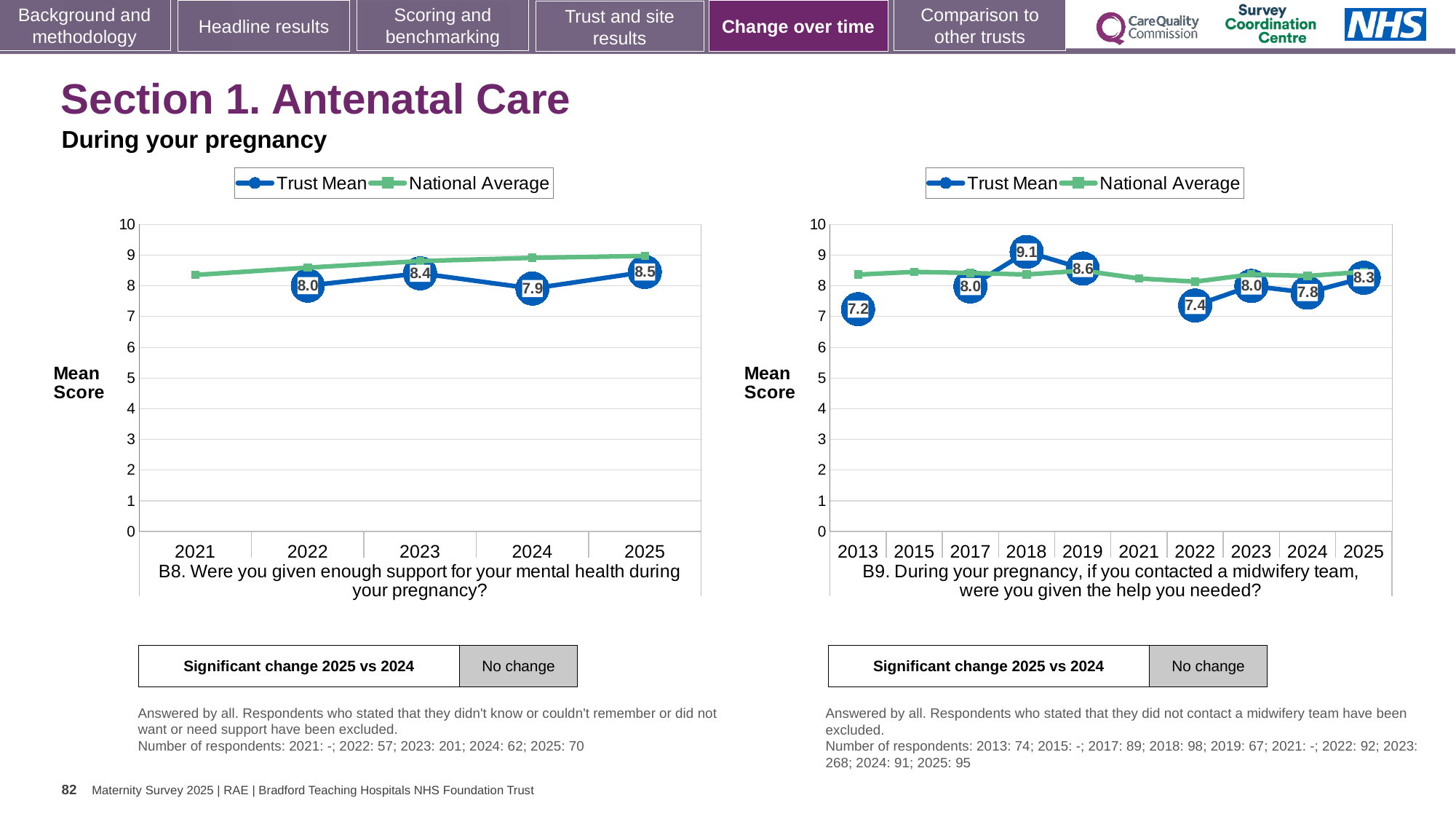
In the B8 chart (left), what is the Trust Mean for 2024? 7.9 In the B8 chart (left), which year has the lowest labelled Trust Mean? 2024 In the B9 chart (right), is the Trust Mean higher in 2019 or in 2022? 2019 In the B9 chart (right), which year has the lowest labelled Trust Mean? 2013 In the B8 chart (left), what is the Trust Mean for 2025? 8.5 In the B9 chart (right), what is the Trust Mean for 2018? 9.1 What type of chart is used for the B8 question on the left? Line chart In the B9 chart (right), how many years are shown on the x axis? 10 In the B8 chart (left), how many series does the legend list? 2 In the B8 chart (left), what is the difference between the Trust Mean for 2025 and 2024? 0.6 In the B9 chart (right), what is the Trust Mean for 2013? 7.2 In the B9 chart (right), which year has the highest Trust Mean? 2018